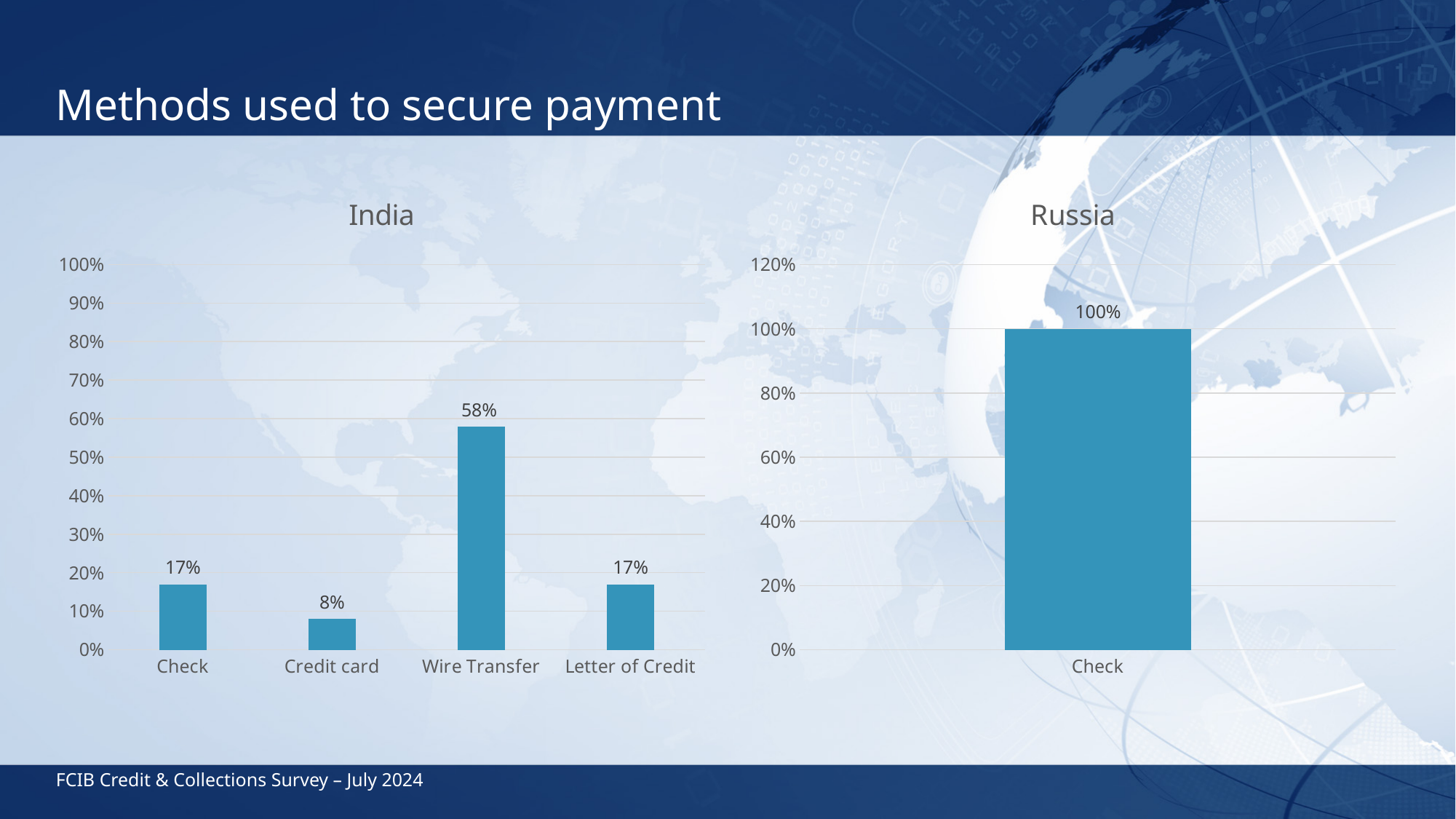
In the India chart, which is larger, Credit card or Letter of Credit? Letter of Credit In the India chart, what is the value for Letter of Credit? 17% How many categories are shown in the India chart? 4 In the India chart, which category has the highest value? Wire Transfer In the Russia chart, what is the value for Check? 100% In the India chart, what is the value for Credit card? 8% In the India chart, what is the value for Wire Transfer? 58% In the India chart, what is the difference between Wire Transfer and Check? 41% In the India chart, which category has the lowest value? Credit card What is the title of the chart on the right side of the slide? Russia What kind of chart is the India chart? Bar chart In the India chart, what is the difference between Check and Credit card? 9%